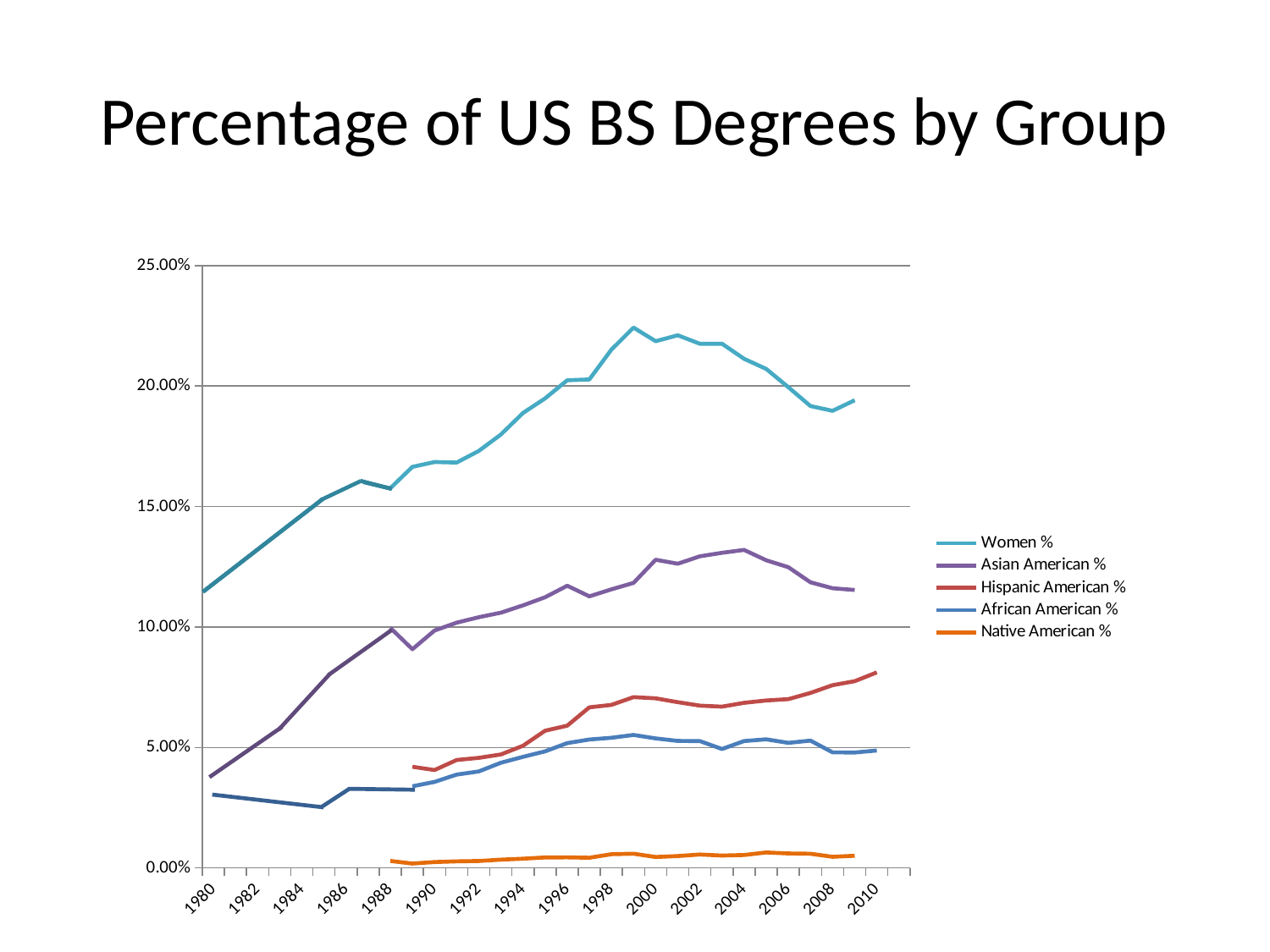
Is the value for Hispanic American % in 2010 greater or less than 10.00%? less Does the Women % line rise or fall between 1980 and 1999? rise What kind of chart is shown on the slide? line chart Which series has the highest values across the chart? Women % Is the value for Women % in 1980 greater or less than 15.00%? less What is the title of the chart? Percentage of US BS Degrees by Group In 2010, which is higher: Hispanic American % or African American %? Hispanic American % How many series does the legend list? 5 Is the value for Women % in 1999 greater or less than 20.00%? greater Which series has the lowest values across the chart? Native American %